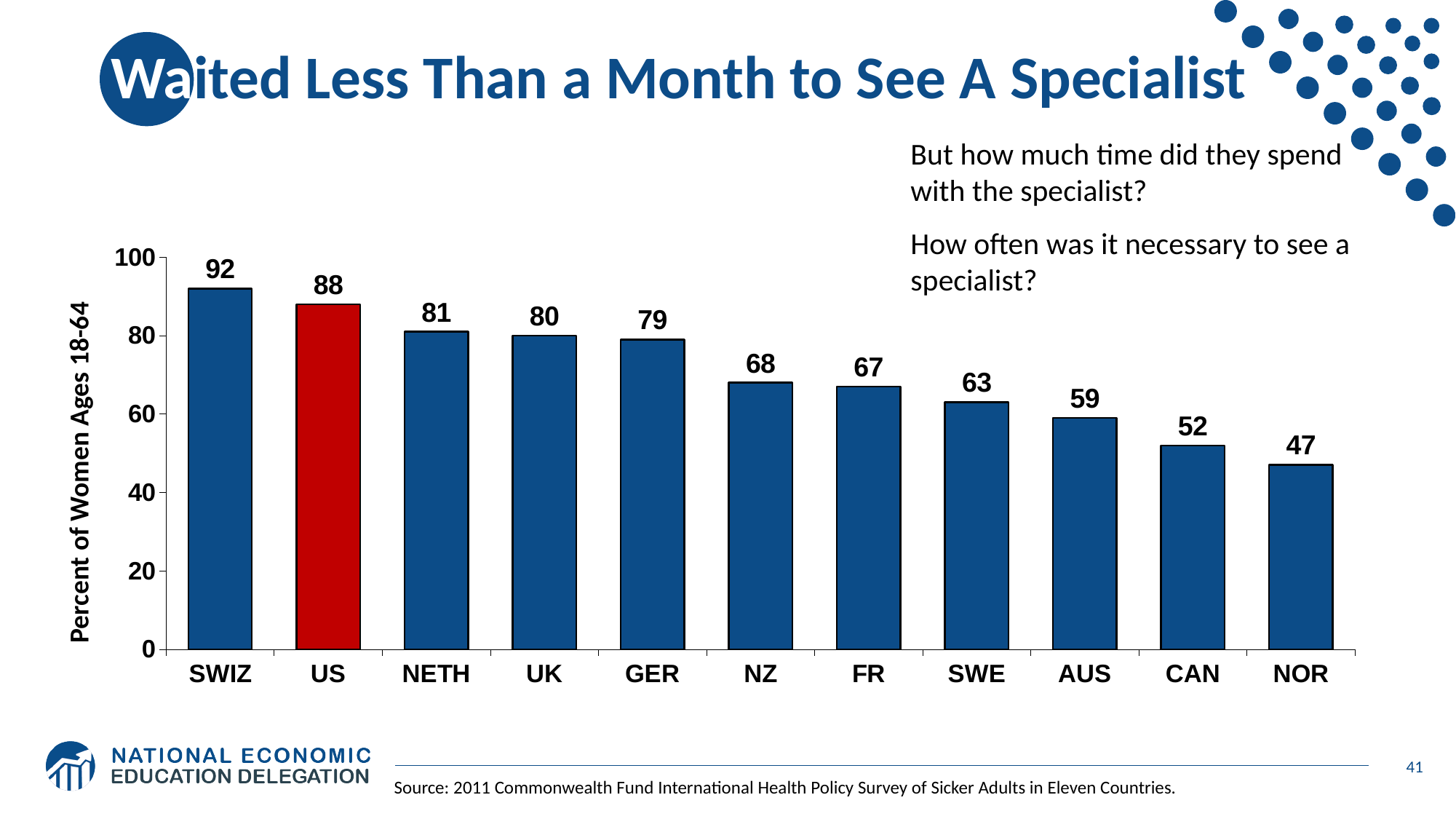
Which country has the highest value? SWIZ What is the difference between the values for SWIZ and the US? 4 What kind of chart is shown on the slide? bar chart What is the value for the US? 88 What is the value for NOR? 47 How many countries are shown on the chart? 11 What is the difference between the values for NZ and CAN? 16 Which country's bar is coloured red? US Is the value for FR greater or less than 60? greater What is the value for GER? 79 Which country has the lowest value? NOR Which has a larger value, SWE or AUS? SWE